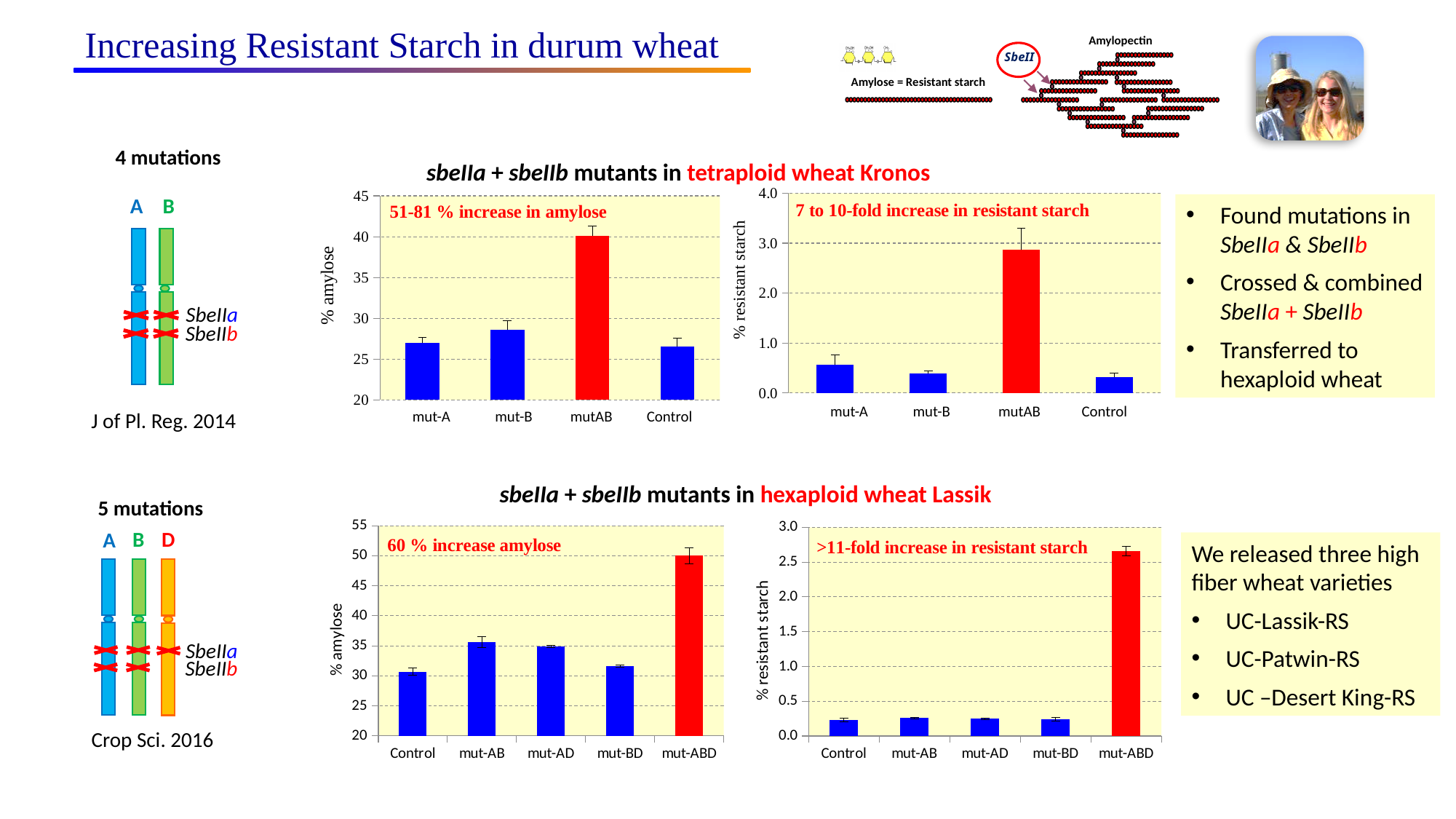
In the % resistant starch chart for tetraploid wheat Kronos (top right), which category has the highest value? mutAB In the % amylose chart for hexaploid wheat Lassik (bottom left), which is larger, the value for mut-AB or the value for Control? mut-AB How many categories are shown on the x axis of the % resistant starch chart for tetraploid wheat Kronos (top right)? 4 How many categories are shown on the x axis of the % amylose chart for hexaploid wheat Lassik (bottom left)? 5 In the % amylose chart for hexaploid wheat Lassik (bottom left), which category has the lowest value? Control In the % resistant starch chart for hexaploid wheat Lassik (bottom right), which category has the highest value? mut-ABD What kind of chart is the % resistant starch chart for tetraploid wheat Kronos (top right)? bar chart What annotation text is printed inside the % amylose chart for hexaploid wheat Lassik (bottom left)? 60 % increase amylose In the % resistant starch chart for hexaploid wheat Lassik (bottom right), is the value for mut-ABD greater or less than 2.5? greater In the % amylose chart for tetraploid wheat Kronos (top left), which category has the highest value? mutAB In the % amylose chart for tetraploid wheat Kronos (top left), is the value for mutAB greater or less than 35? greater